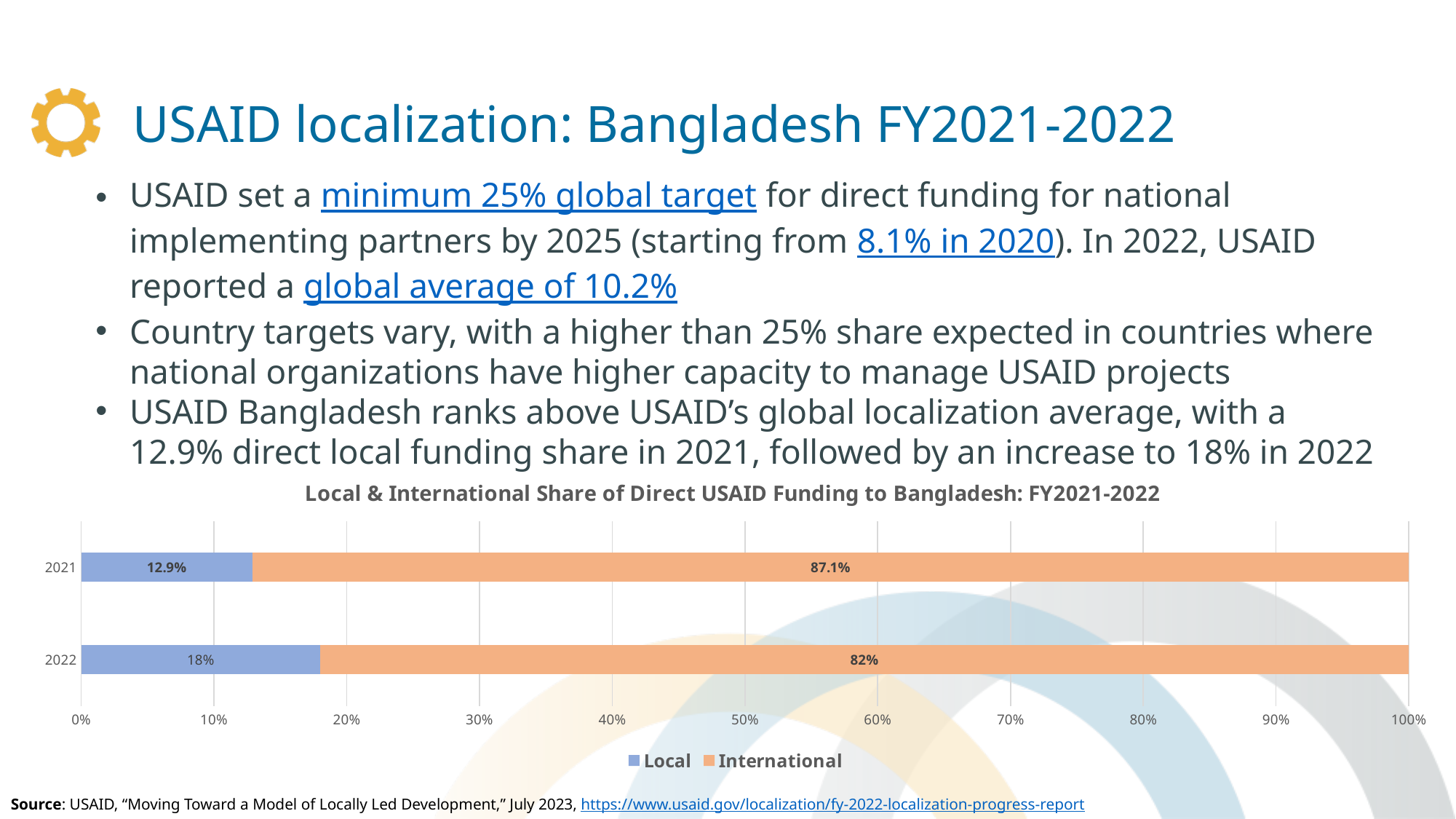
By how many percentage points did the Local share increase from 2021 to 2022? 5.1 Which year has the lower International share? 2022 How many series does the legend list? 2 What is the Local share of direct USAID funding to Bangladesh in 2021? 12.9% What kind of chart is shown on the slide? Stacked bar chart What is the title of the chart? Local & International Share of Direct USAID Funding to Bangladesh: FY2021-2022 What is the Local share in 2022? 18% Which year has the higher Local share? 2022 How many years are shown on the chart? 2 Is the International share larger in 2021 or 2022? 2021 What is the International share of direct USAID funding to Bangladesh in 2022? 82% What is the International share in 2021? 87.1%